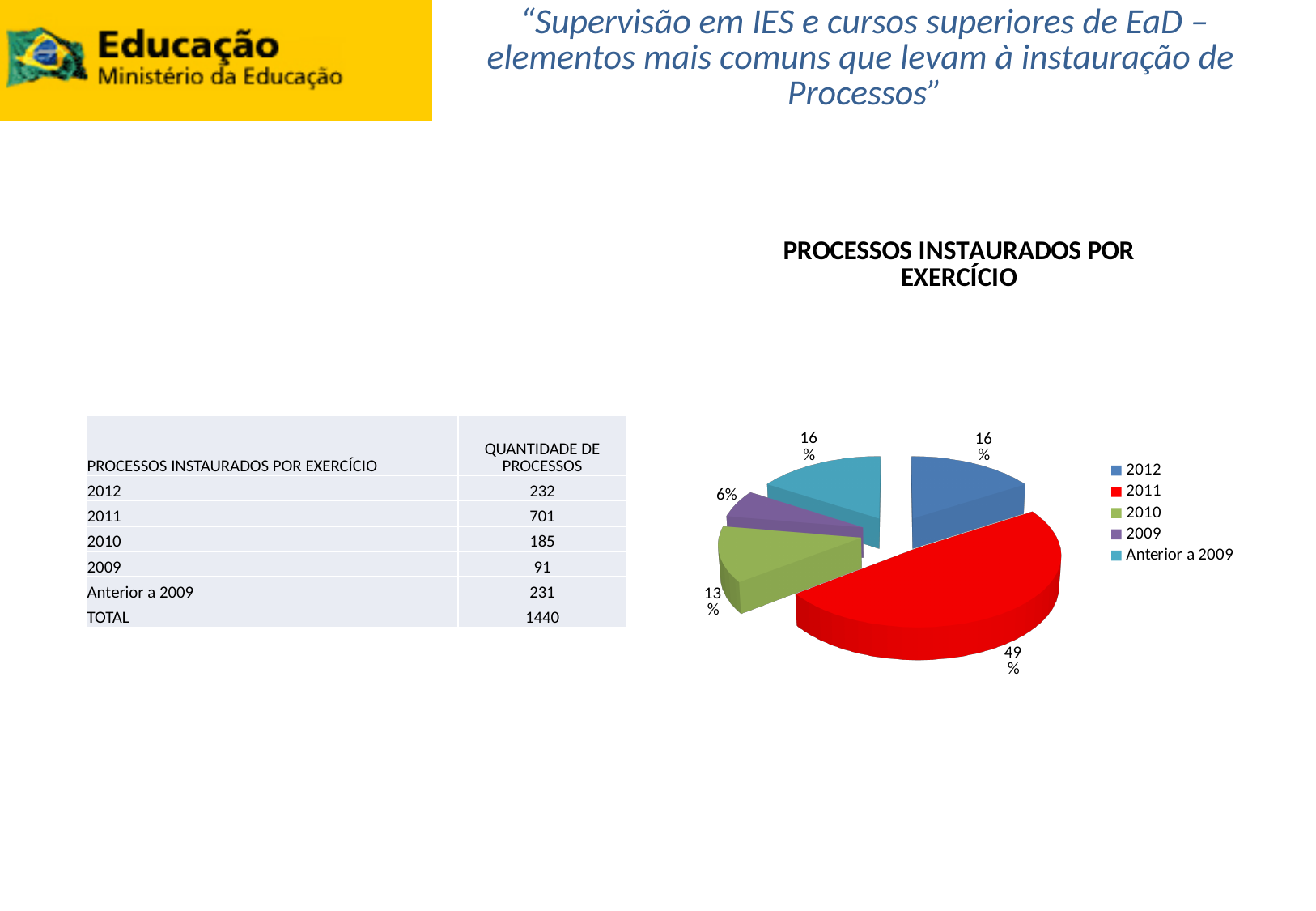
What is the difference in percentage points between the 2011 slice and the 2012 slice? 33 Which category has the smallest slice of the pie? 2009 Which slice is larger, 2010 or 2009? 2010 What share of the pie does 2009 represent? 6% What share of the pie does 2010 represent? 13% What kind of chart is shown under the title "PROCESSOS INSTAURADOS POR EXERCÍCIO"? pie chart How many slices does the pie chart have? 5 What share of the pie does "Anterior a 2009" represent? 16% How many entries does the legend of the pie chart list? 5 Which category has the largest slice of the pie? 2011